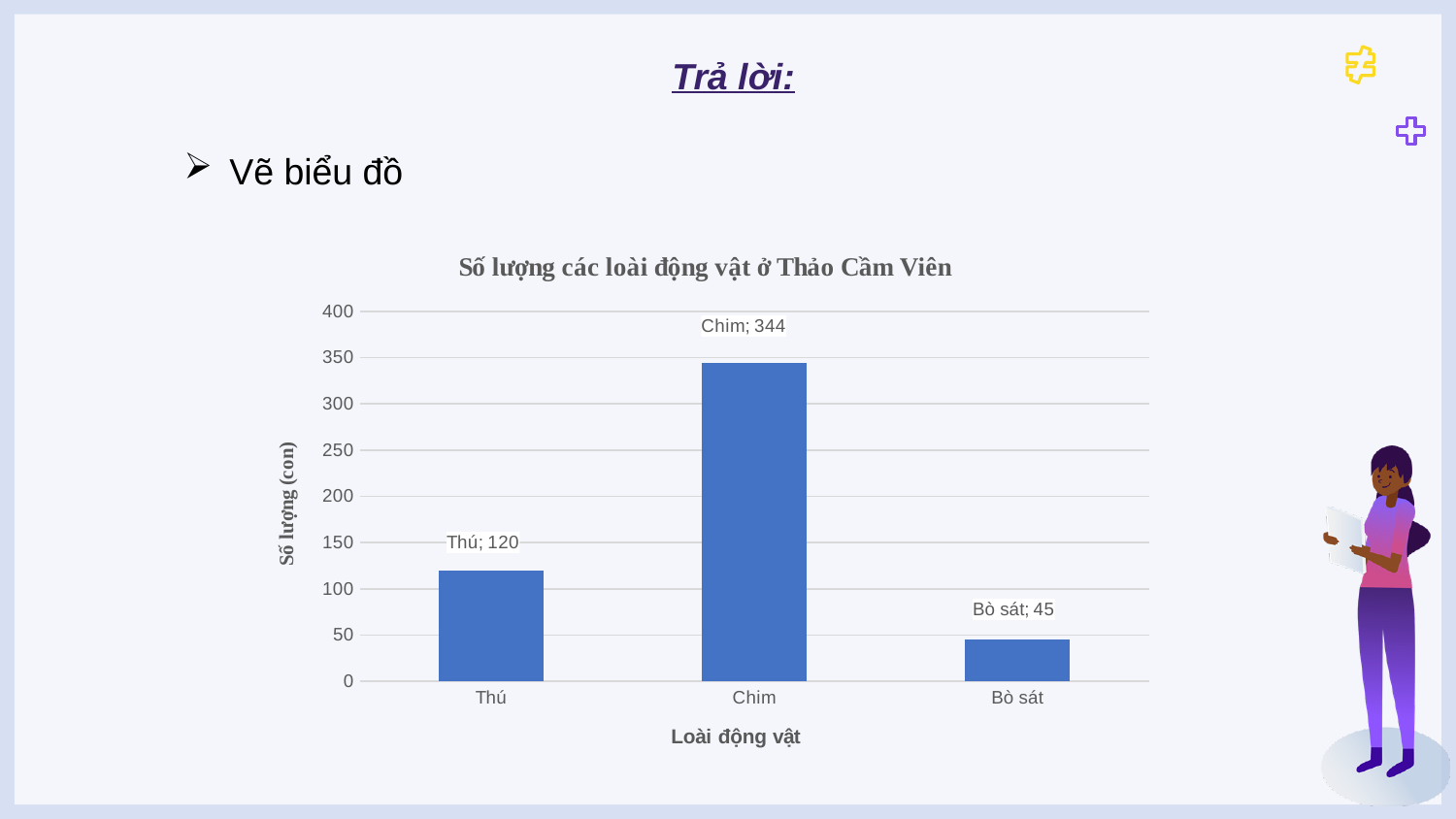
What is the difference between the values for Thú and Bò sát? 75 Which category has the highest value? Chim What is the value for Thú? 120 What is the difference between the values for Chim and Thú? 224 Is the value for Chim greater or less than 300? greater Which category has the lowest value? Bò sát How many categories are shown on the x axis? 3 What is the value for Bò sát? 45 What is the value for Chim? 344 Which is larger, the value for Thú or the value for Bò sát? Thú What kind of chart is this? bar chart What is the title of the chart? Số lượng các loài động vật ở Thảo Cầm Viên